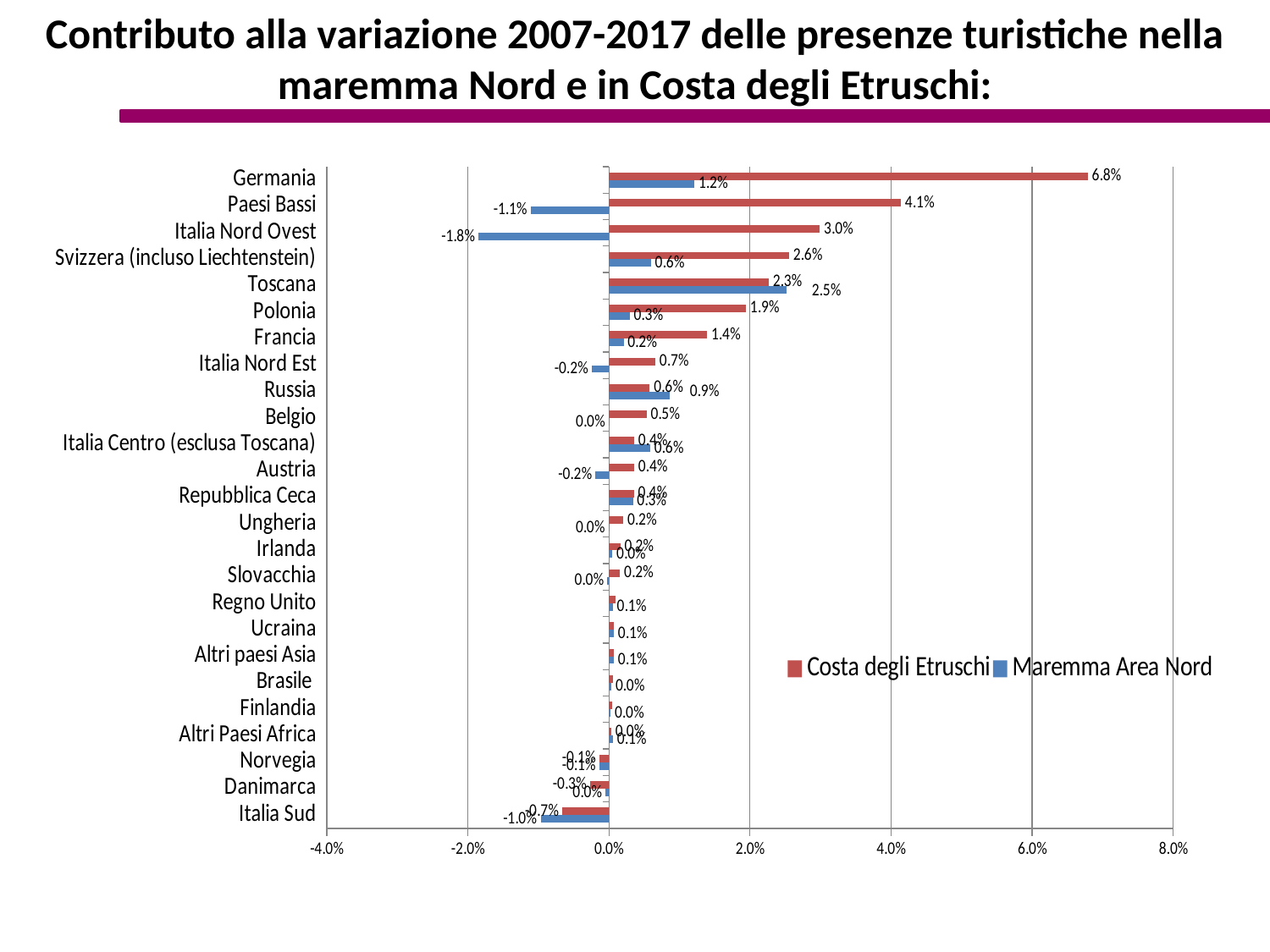
For Toscana, which series has the larger value: Costa degli Etruschi or Maremma Area Nord? Maremma Area Nord What is the value for Germania in the Costa degli Etruschi series? 6.8% Which category has the lowest value in the Maremma Area Nord series? Italia Nord Ovest How many categories are shown on the chart? 25 Which category has the highest value in the Costa degli Etruschi series? Germania What colour represents the Costa degli Etruschi series? Red Is the Costa degli Etruschi value for Francia greater or less than 2.0%? less What is the value for Russia in the Maremma Area Nord series? 0.9% What kind of chart is shown on the slide? Bar chart How many series does the legend list? 2 What is the difference between the Costa degli Etruschi and Maremma Area Nord values for Germania? 5.6 percentage points What is the value for Paesi Bassi in the Maremma Area Nord series? -1.1%